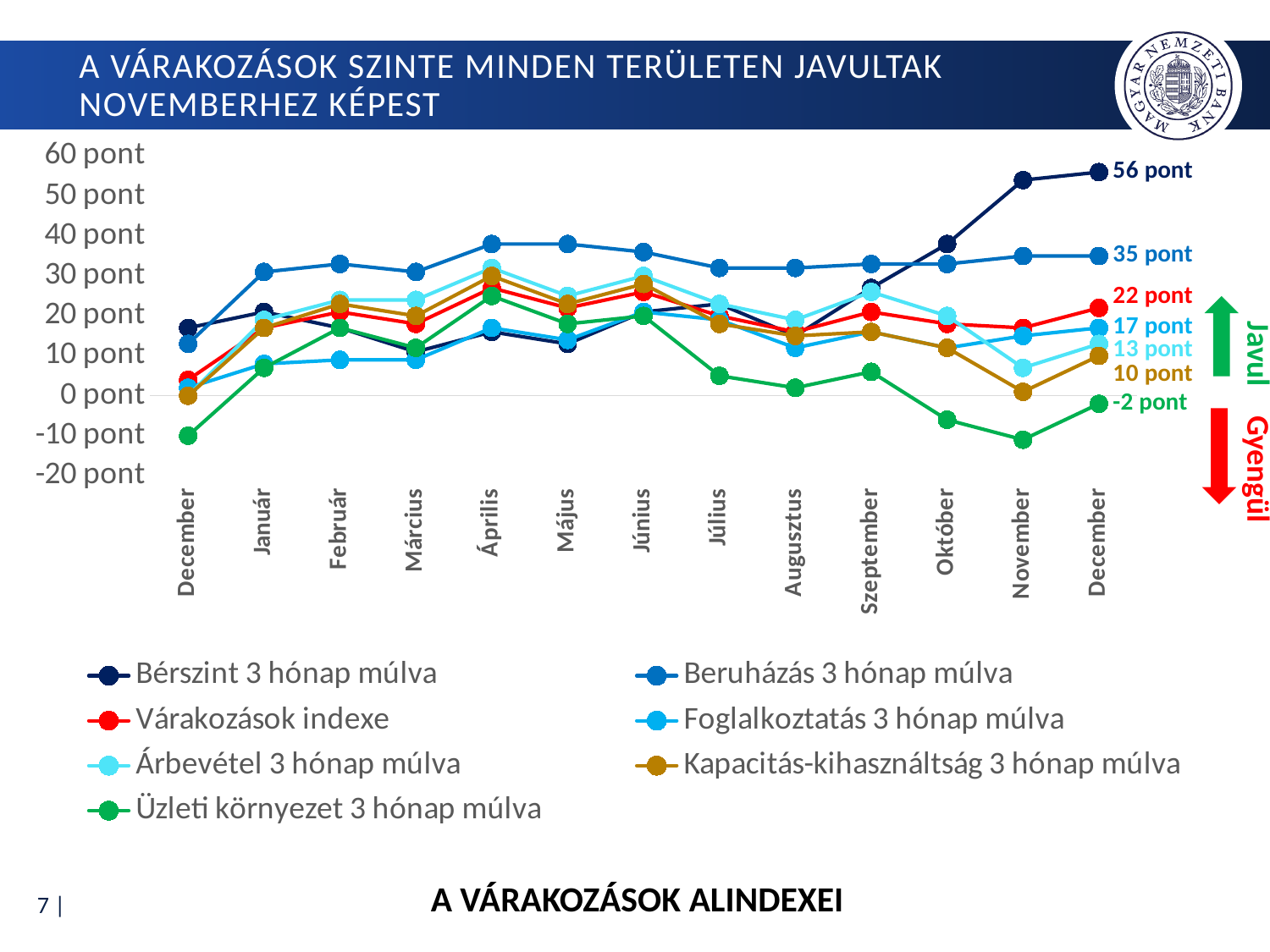
Is the value for Üzleti környezet 3 hónap múlva in the first December greater or less than 0 pont? less What is the final December value for Üzleti környezet 3 hónap múlva? -2 pont Which series has the highest value in the final December? Bérszint 3 hónap múlva How many series does the legend list? 7 How many months are shown along the x axis? 13 What is the final December value for Beruházás 3 hónap múlva? 35 pont Which series has the lowest value in the final December? Üzleti környezet 3 hónap múlva What is the final December value for Várakozások indexe? 22 pont Does the Bérszint 3 hónap múlva series rise or fall between Szeptember and the final December? rise What is the final December value for Bérszint 3 hónap múlva? 56 pont What is the difference between the final December values of Bérszint 3 hónap múlva and Beruházás 3 hónap múlva? 21 pont What type of chart is shown on the slide? line chart